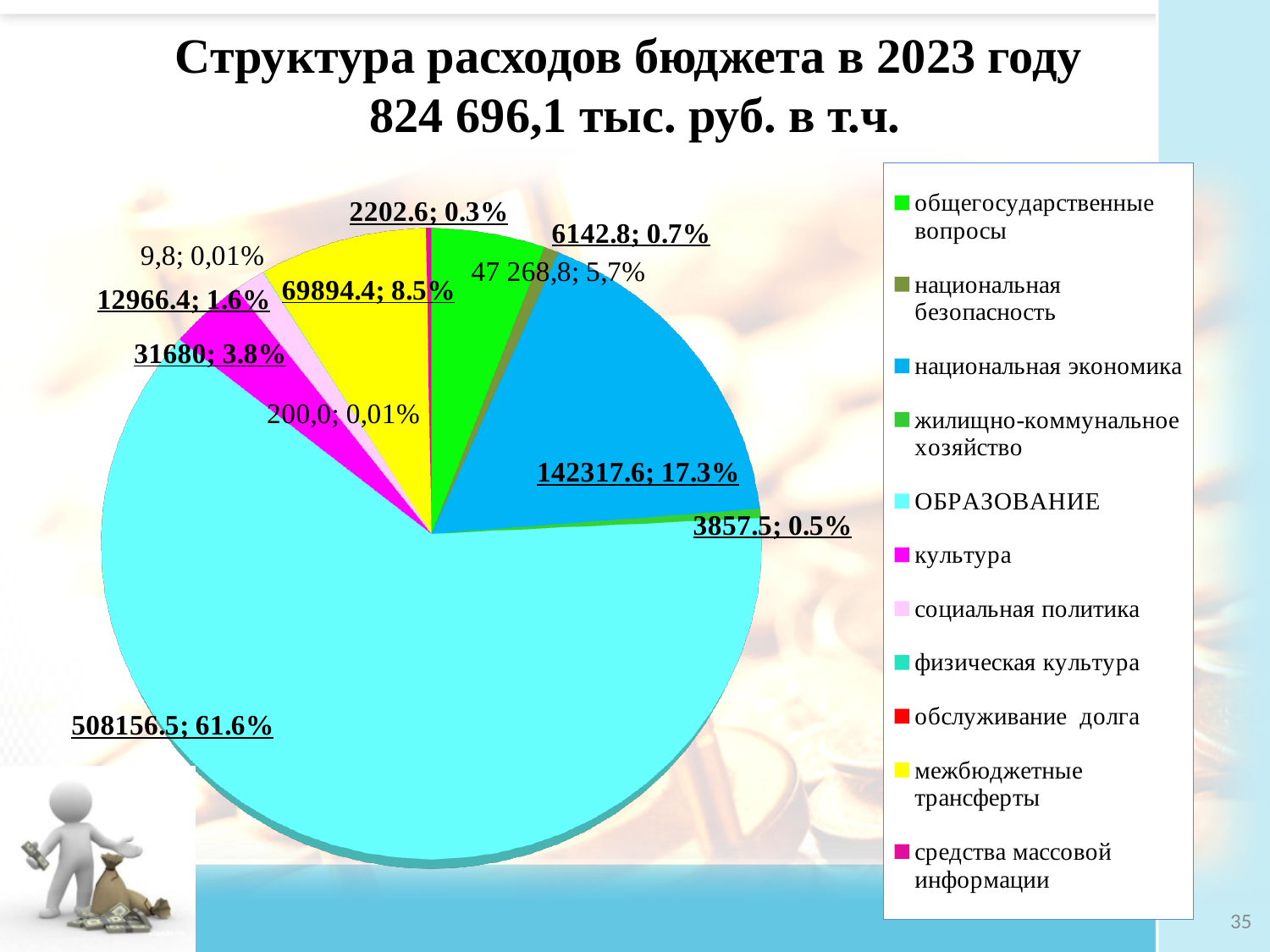
Which category has the largest slice of the pie chart? ОБРАЗОВАНИЕ Which is larger, the slice for ОБРАЗОВАНИЕ or the slice for национальная экономика? ОБРАЗОВАНИЕ What share of the pie does культура account for? 3.8% What value is labelled for национальная экономика on the pie chart? 142317.6 What kind of chart is shown on the slide? pie chart By how many percentage points does the share of ОБРАЗОВАНИЕ exceed the share of национальная экономика? 44.3% What total budget expenditure is stated in the slide title? 824 696,1 тыс. руб. How many categories does the legend of the pie chart list? 11 What share of the pie does национальная экономика account for? 17.3% What share of the pie does ОБРАЗОВАНИЕ account for? 61.6% What value is labelled for ОБРАЗОВАНИЕ on the pie chart? 508156.5